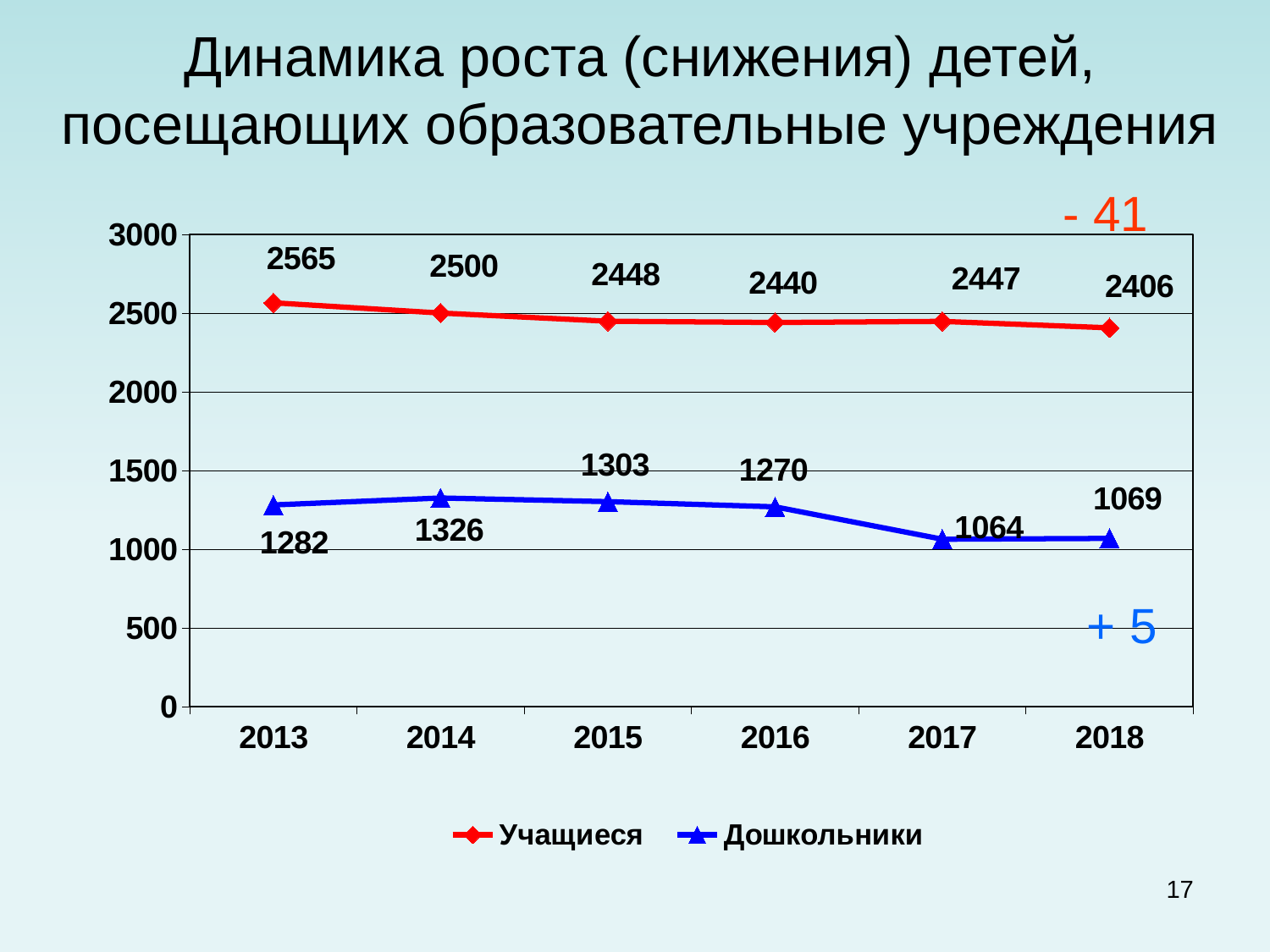
In which year is the value for Учащиеся lowest? 2018 What is the value for Учащиеся in 2013? 2565 In which year is the value for Дошкольники highest? 2014 Which is larger: Дошкольники in 2015 or Дошкольники in 2018? 2015 What is the value for Учащиеся in 2018? 2406 How many years are shown on the x axis? 6 What is the difference between the Учащиеся values in 2013 and 2018? 159 Is the value for Учащиеся in 2016 greater or less than 2000? greater How many series does the legend list? 2 What is the value for Дошкольники in 2017? 1064 What is the difference between the Дошкольники values in 2016 and 2017? 206 What kind of chart is shown on the slide? line chart